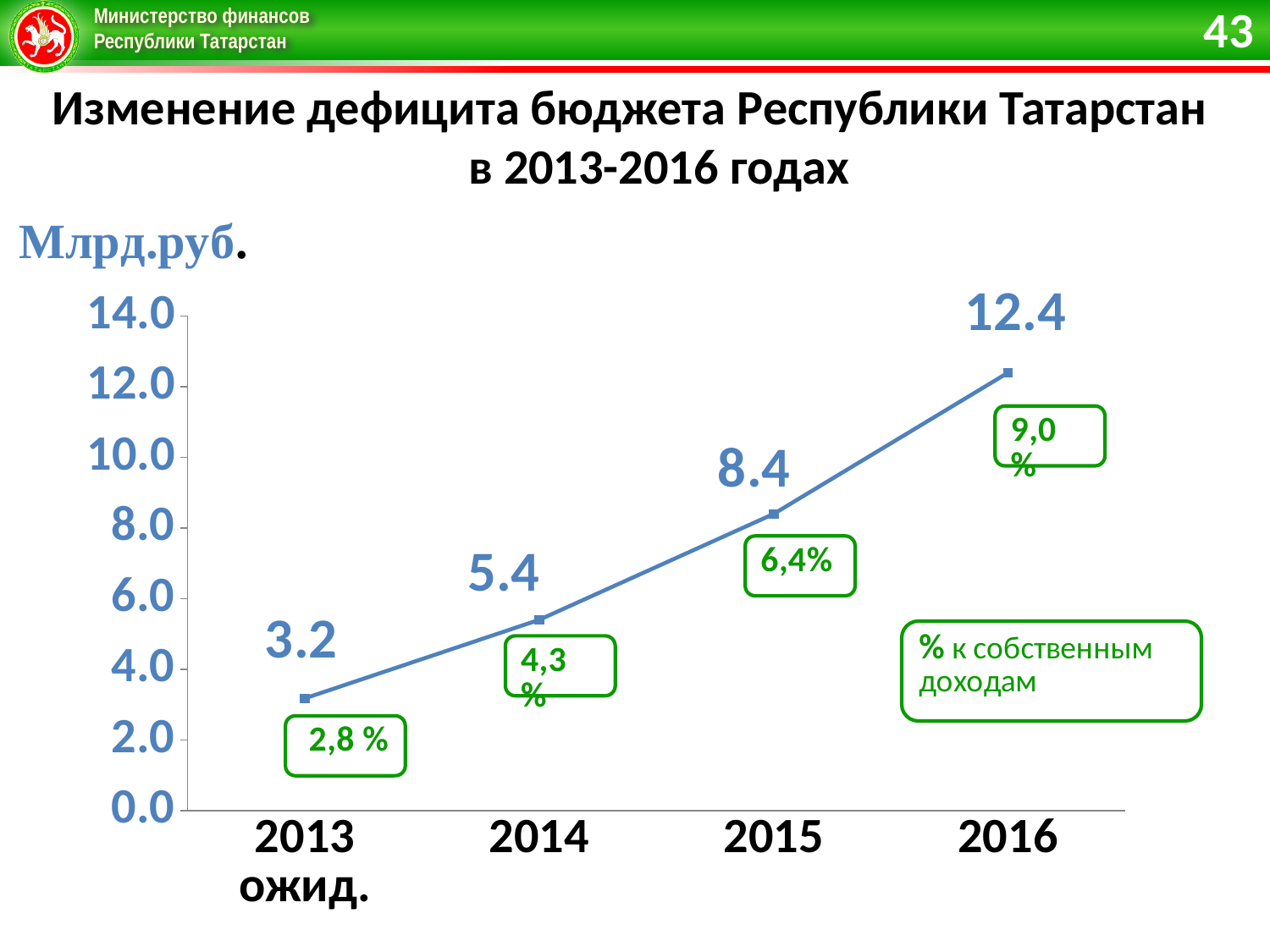
What is the budget deficit value for 2013 (ожид.)? 3.2 Do the deficit values rise or fall from 2013 to 2016? rise Which year has the lowest budget deficit? 2013 ожид. What is the budget deficit value for 2016? 12.4 Which year has the highest budget deficit? 2016 What kind of chart is shown on the slide? line chart What is the difference between the deficit values for 2014 and 2013? 2.2 What percentage of own revenues does the deficit represent in 2015, according to the green label? 6,4% What is the budget deficit value for 2015? 8.4 What is the difference between the deficit values for 2016 and 2015? 4.0 How many years are plotted on the chart? 4 Which is larger, the deficit for 2014 or for 2015? 2015